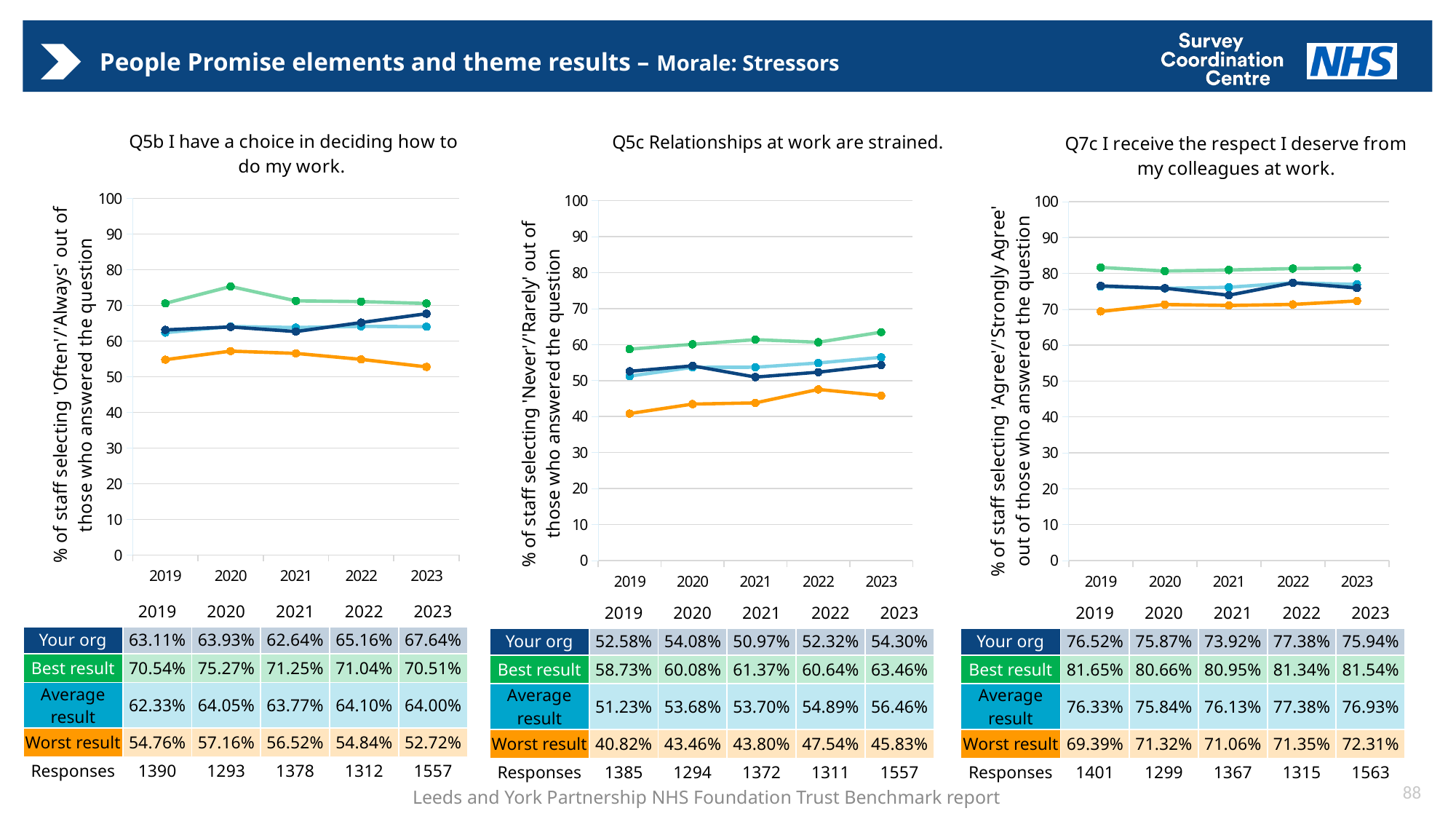
In the chart 'Q5b I have a choice in deciding how to do my work.', what is the difference between the 'Best result' and 'Worst result' in 2023? 17.79 percentage points How many years are plotted on the x axis of the chart 'Q7c I receive the respect I deserve from my colleagues at work.'? 5 In the chart 'Q5c Relationships at work are strained.', what is the 'Worst result' value for 2022? 47.54% In the chart 'Q5c Relationships at work are strained.', does the 'Best result' rise or fall from 2019 to 2023? Rise In the chart 'Q7c I receive the respect I deserve from my colleagues at work.', how many responses were recorded in 2023? 1563 In the chart 'Q5c Relationships at work are strained.', which is larger in 2023: 'Your org' or 'Average result'? Average result In the chart 'Q5b I have a choice in deciding how to do my work.', in which year is the 'Best result' highest? 2020 In the chart 'Q5c Relationships at work are strained.', in which year is the 'Your org' value lowest? 2021 In the chart 'Q7c I receive the respect I deserve from my colleagues at work.', is the 'Best result' value for 2019 greater or less than 80? greater In the chart 'Q5b I have a choice in deciding how to do my work.', what is the 'Your org' value for 2023? 67.64% In the chart 'Q7c I receive the respect I deserve from my colleagues at work.', what is the 'Average result' value for 2022? 77.38% What kind of chart is used for 'Q5c Relationships at work are strained.'? Line chart